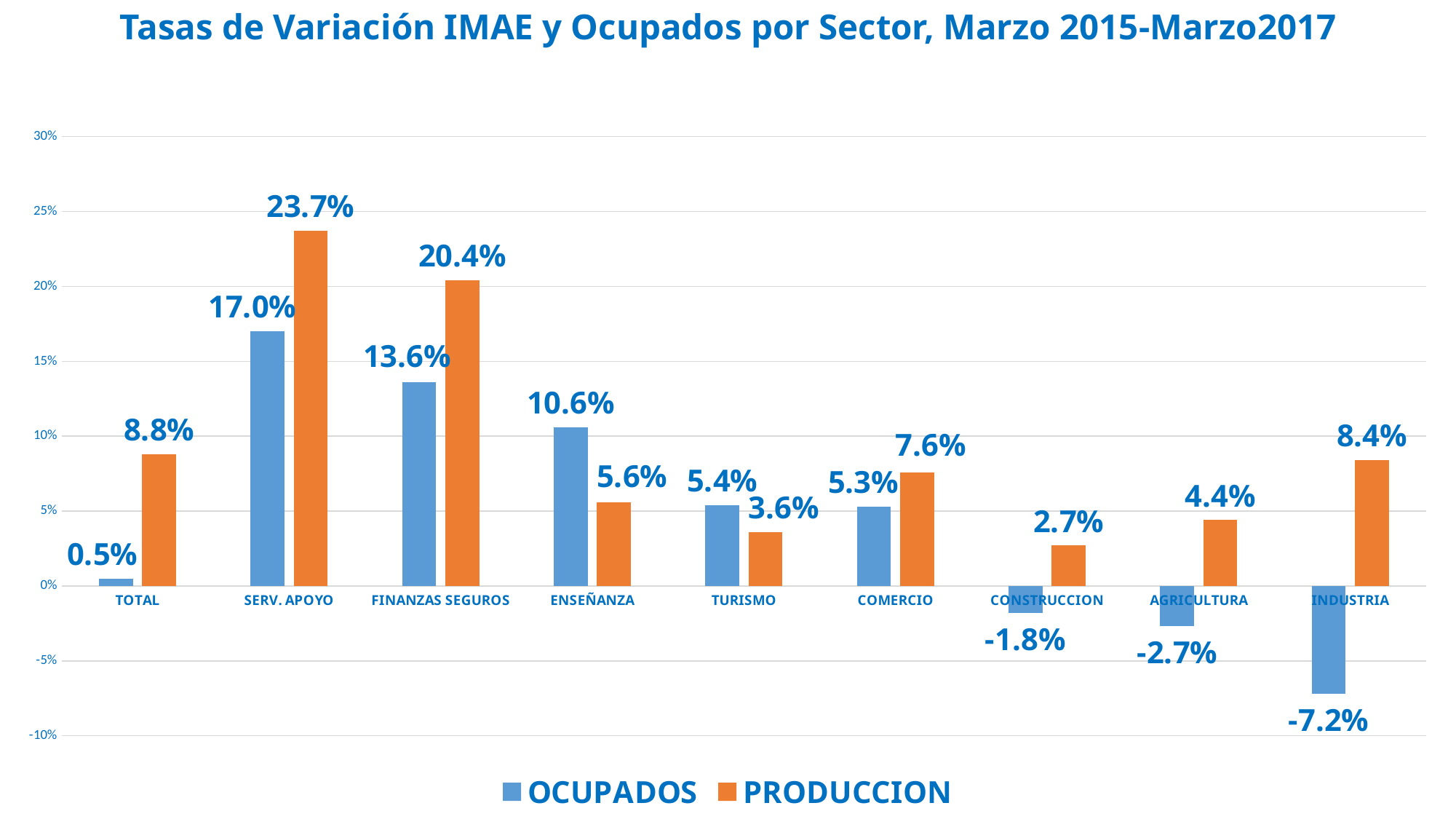
What is the OCUPADOS value for SERV. APOYO? 17.0% What is the PRODUCCION value for AGRICULTURA? 4.4% How many categories are shown on the x axis? 9 Which colour represents the PRODUCCION series? Orange Which category has the lowest OCUPADOS value? INDUSTRIA What is the OCUPADOS value for INDUSTRIA? -7.2% What is the PRODUCCION value for FINANZAS SEGUROS? 20.4% Which is larger for ENSEÑANZA, the OCUPADOS value or the PRODUCCION value? OCUPADOS What is the difference between the PRODUCCION and OCUPADOS values for TOTAL? 8.3% What kind of chart is shown on the slide? Bar chart Which category has the highest PRODUCCION value? SERV. APOYO How many series does the legend list? 2